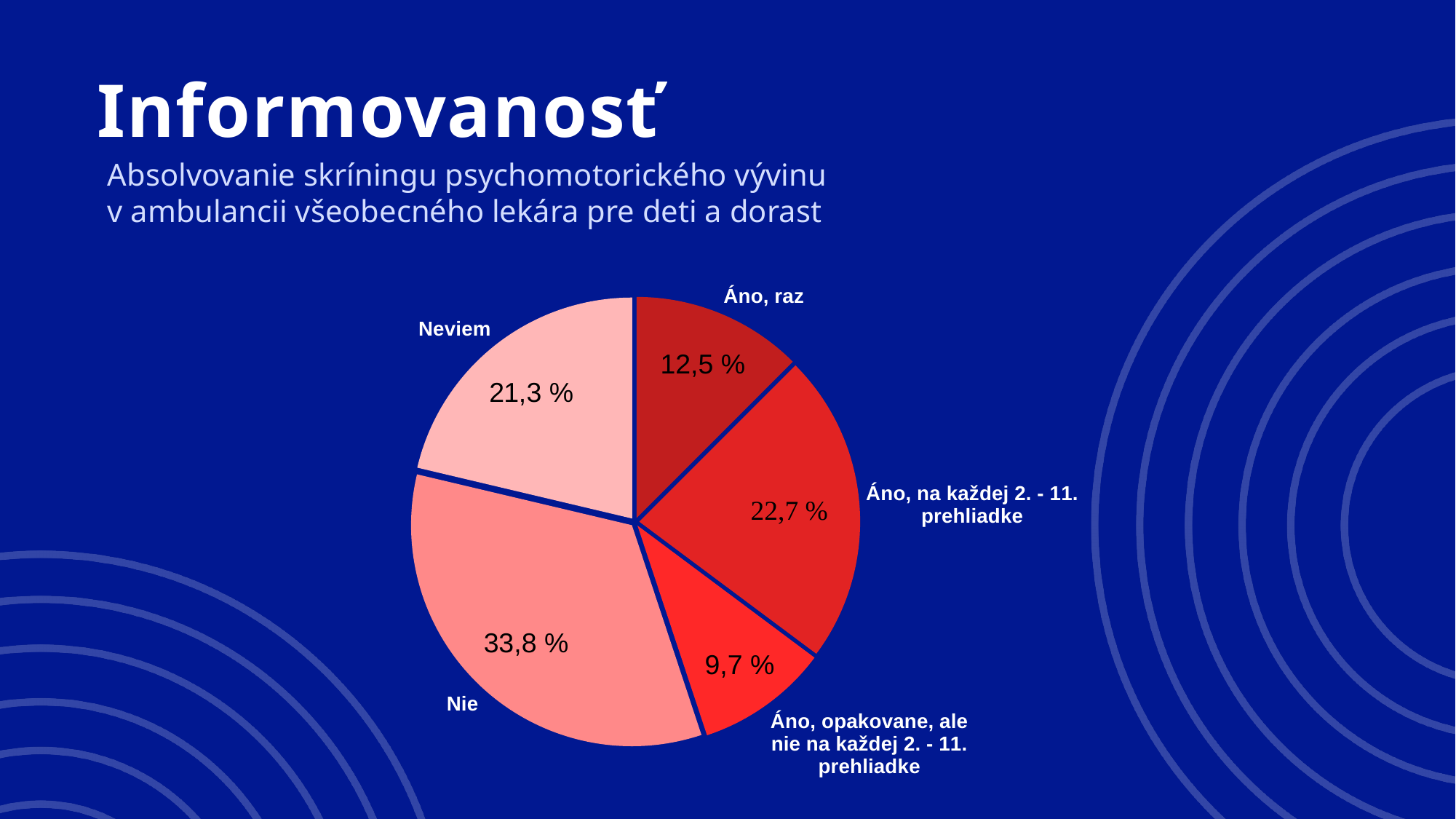
What is the value for "Áno, raz"? 12,5 % Which category has the largest share of the pie? Nie How many slices does the pie chart have? 5 What is the value for "Áno, opakovane, ale nie na každej 2. - 11. prehliadke"? 9,7 % What kind of chart is shown on the slide? Pie chart What is the value for "Áno, na každej 2. - 11. prehliadke"? 22,7 % What is the value for "Neviem"? 21,3 % What is the subtitle describing the chart on the slide? Absolvovanie skríningu psychomotorického vývinu v ambulancii všeobecného lekára pre deti a dorast Which category has the smallest share of the pie? Áno, opakovane, ale nie na každej 2. - 11. prehliadke What is the value for "Nie"? 33,8 % What is the difference between the values for "Nie" and "Neviem"? 12,5 % Which is larger, the value for "Áno, raz" or the value for "Áno, na každej 2. - 11. prehliadke"? Áno, na každej 2. - 11. prehliadke